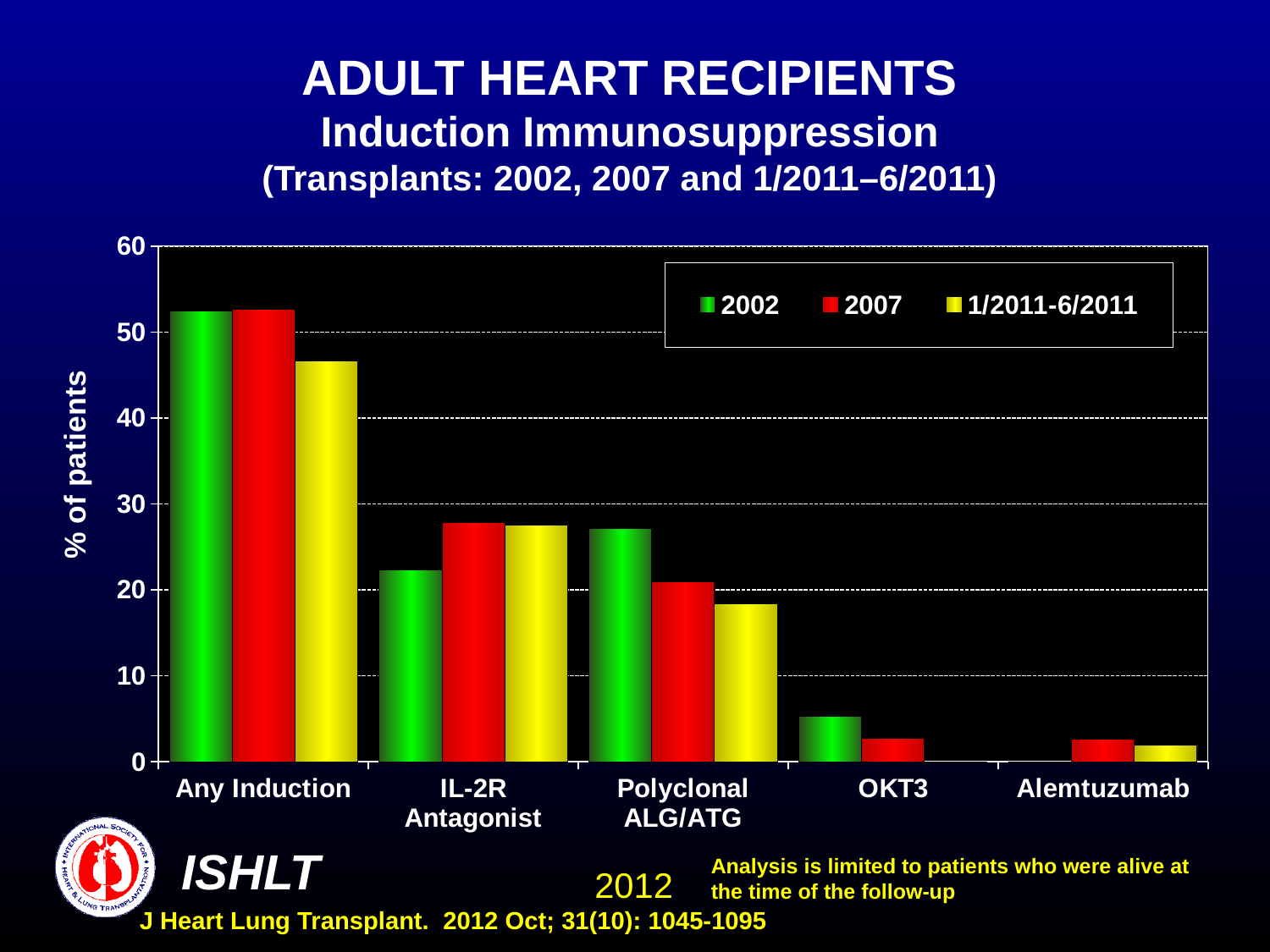
Is the 1/2011-6/2011 value for Polyclonal ALG/ATG greater or less than 20? less How many series does the legend list? 3 Is the 2002 value for IL-2R Antagonist greater or less than 20? greater For Polyclonal ALG/ATG, which is larger: the 2002 value or the 2007 value? 2002 Is the 2002 value for Any Induction greater or less than 50? greater How many induction categories are shown on the x axis? 5 For IL-2R Antagonist, which is larger: the 2002 value or the 2007 value? 2007 Do the values for Polyclonal ALG/ATG rise or fall from 2002 to 1/2011-6/2011? fall What kind of chart is shown on the slide? bar chart Which category has the highest 2007 value? Any Induction Which category has the lowest 2002 value? Alemtuzumab